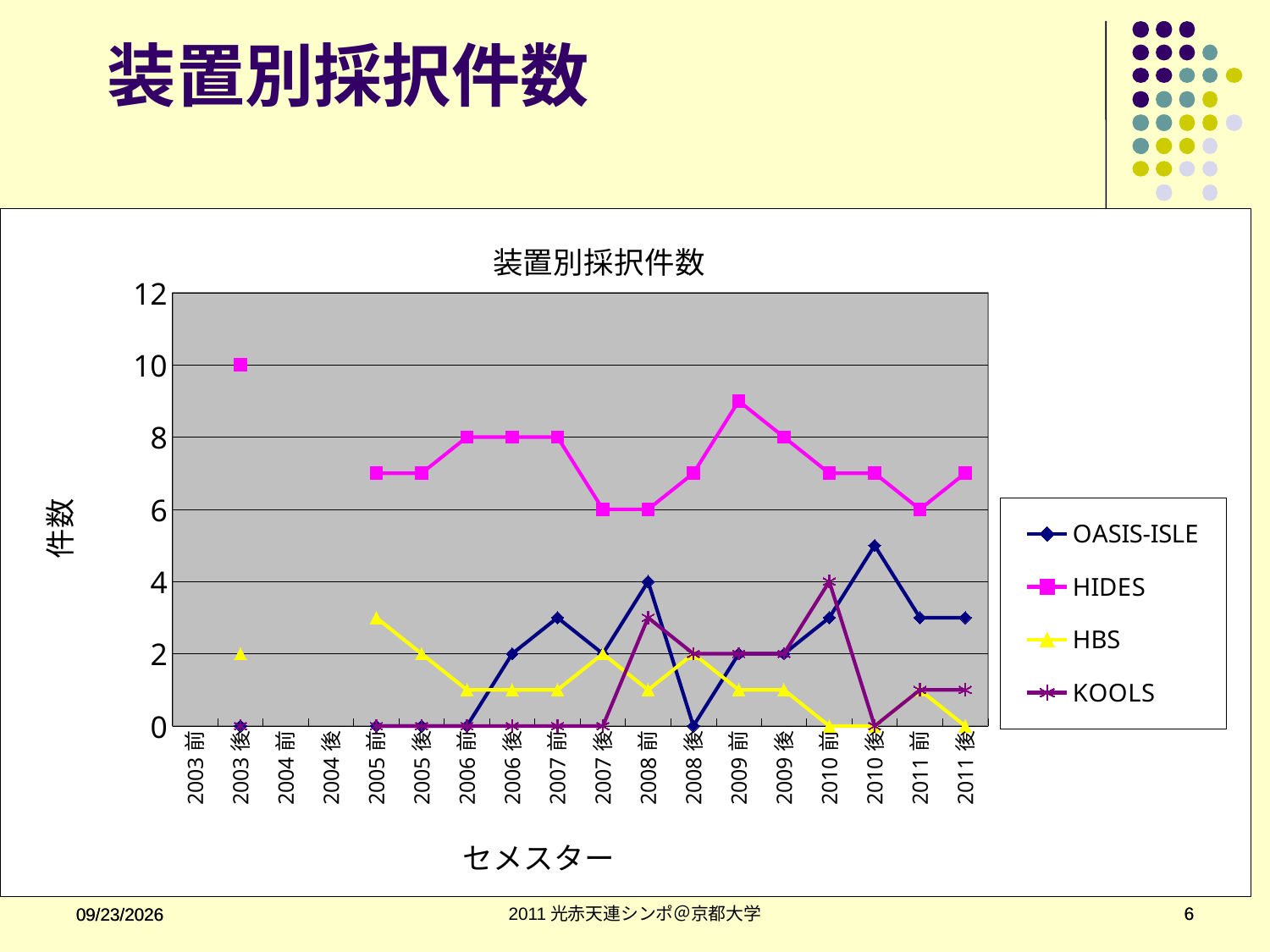
What kind of chart is shown on the slide? line chart In which semester does OASIS-ISLE reach its highest value? 2010後 What is the value for OASIS-ISLE in 2008前? 4 What is the title of the chart? 装置別採択件数 In which semester does HIDES reach its highest value? 2003後 What is the value for HIDES in 2003後? 10 What is the value for HBS in 2010後? 0 How many semesters are shown on the x axis? 18 Which series has the larger value in 2010後, OASIS-ISLE or HIDES? HIDES How many series does the legend list? 4 Is the value for HIDES in 2009前 greater or less than 8? greater What is the value for KOOLS in 2010前? 4